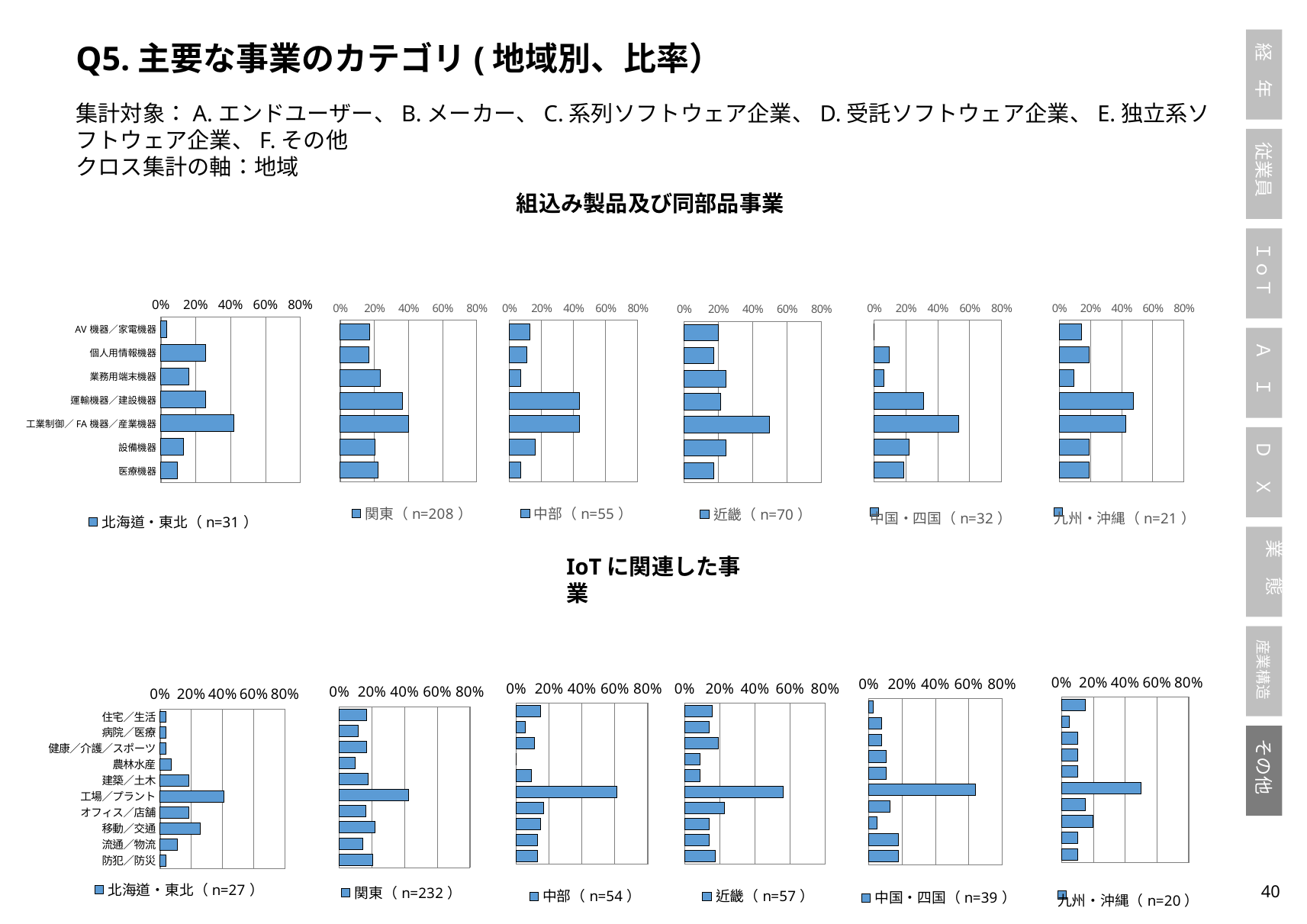
In the 組込み製品及び同部品事業 chart for 中部 (n=55), which is larger: 運輸機器／建設機器 or 医療機器? 運輸機器／建設機器 How many series does the legend of the 関東 chart under 組込み製品及び同部品事業 list? 1 In the 組込み製品及び同部品事業 chart for 北海道・東北 (n=31), which category has the lowest value? AV機器／家電機器 What kind of chart is used for the 組込み製品及び同部品事業 charts? bar chart In the 組込み製品及び同部品事業 chart for 近畿 (n=70), is the value for 工業制御／FA機器／産業機器 greater or less than 40%? greater What is the sample size (n) shown in the legend of the 関東 chart under IoTに関連した事業? n=232 How many categories are shown in each 組込み製品及び同部品事業 chart? 7 In the IoTに関連した事業 chart for 中国・四国 (n=39), is the value for 工場／プラント greater or less than 40%? greater How many categories are shown in each IoTに関連した事業 chart? 10 In the IoTに関連した事業 chart for 北海道・東北 (n=27), which category has the highest value? 工場／プラント In the 組込み製品及び同部品事業 chart for 北海道・東北 (n=31), which category has the highest value? 工業制御／FA機器／産業機器 In the IoTに関連した事業 chart for 近畿 (n=57), is the value for 住宅／生活 greater or less than 40%? less